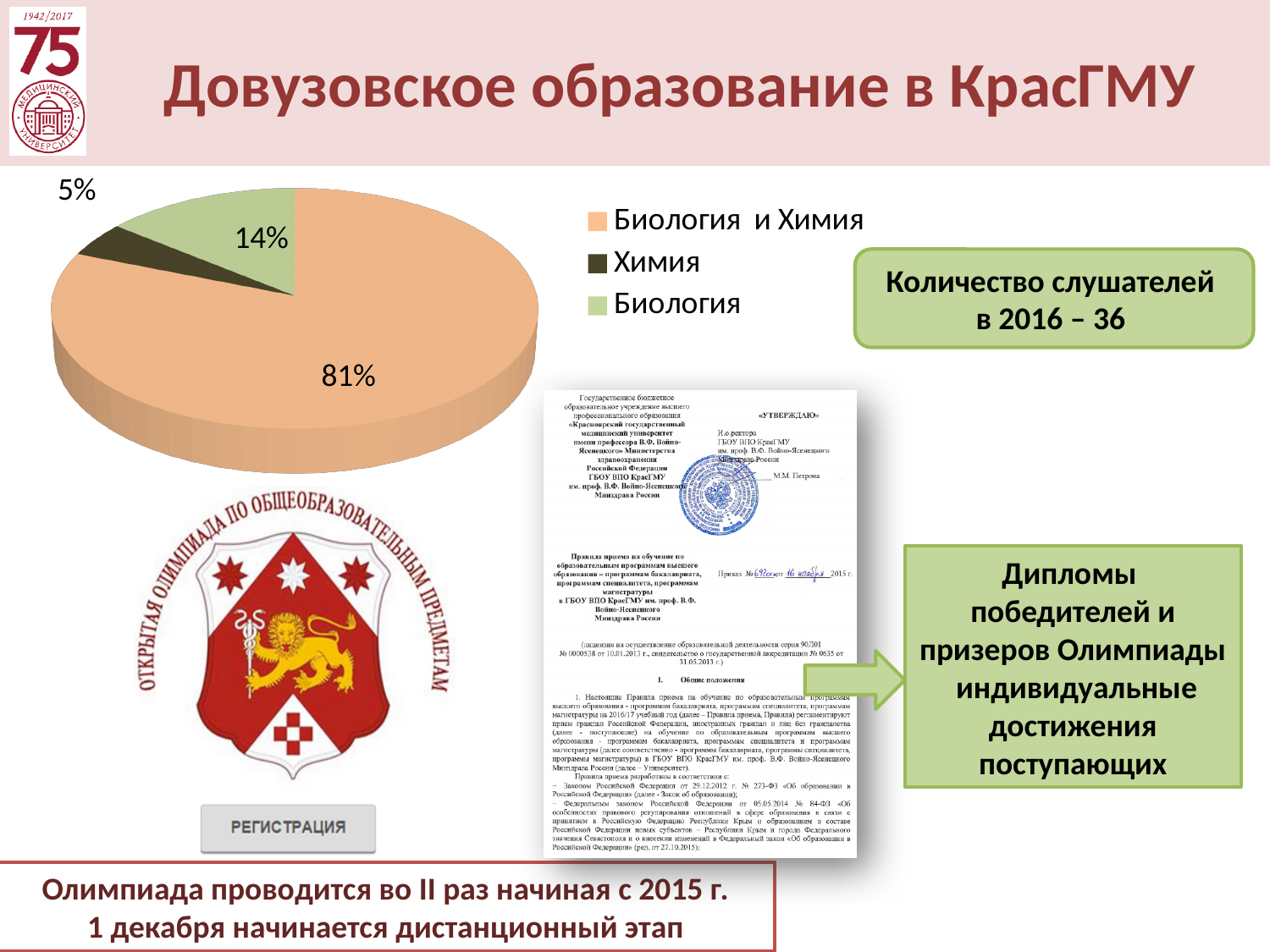
How many slices does the pie chart have? 3 What is the difference in percentage points between the Биология и Химия slice and the Биология slice? 67 What share of the pie does the slice for Биология represent? 14% How many entries does the chart legend list? 3 What is the difference in percentage points between the Биология slice and the Химия slice? 9 Which is larger, the slice for Биология or the slice for Химия? Биология What colour is the slice for Биология и Химия? Orange (peach) Which category has the largest slice of the pie? Биология и Химия What share of the pie does the slice for Биология и Химия represent? 81% Which category has the smallest slice of the pie? Химия What share of the pie does the slice for Химия represent? 5% What kind of chart is shown on the slide? Pie chart